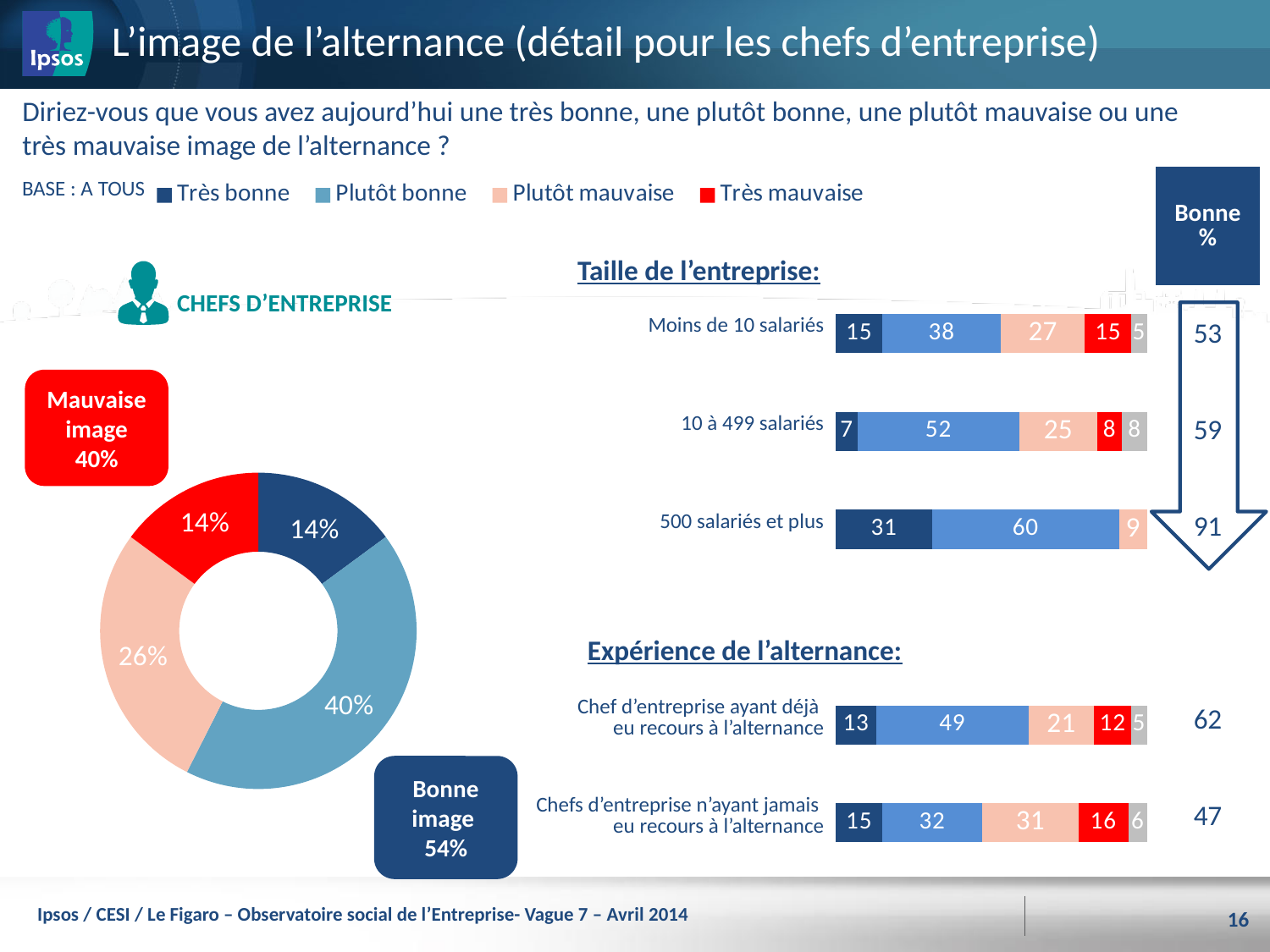
How many categories (bars) are shown in the 'Taille de l'entreprise' chart? 3 In the 'Taille de l'entreprise' chart, which company size has the highest 'Bonne %' total? 500 salariés et plus In the 'Expérience de l'alternance' chart, what is the 'Plutôt mauvaise' value for 'Chefs d'entreprise n'ayant jamais eu recours à l'alternance'? 31 What kind of chart is used on the left of the slide to show the overall image of l'alternance among chefs d'entreprise? Donut (pie) chart In the 'Taille de l'entreprise' chart, what is the difference between the 'Bonne %' for '500 salariés et plus' and for 'Moins de 10 salariés'? 38 How many entries does the legend at the top of the slide list? 4 In the donut chart on the left, which slice is the largest? Plutôt bonne In the 'Taille de l'entreprise' chart, what is the 'Très bonne' value for '10 à 499 salariés'? 7 In the donut chart on the left, what share is shown for the 'Plutôt bonne' slice? 40% In the 'Expérience de l'alternance' chart, which group has the larger 'Plutôt bonne' value: chefs ayant déjà eu recours or chefs n'ayant jamais eu recours à l'alternance? Chef d'entreprise ayant déjà eu recours à l'alternance In the donut chart on the left, what share is shown for the 'Plutôt mauvaise' slice? 26% In the 'Taille de l'entreprise' chart, what is the 'Plutôt bonne' value for '500 salariés et plus'? 60